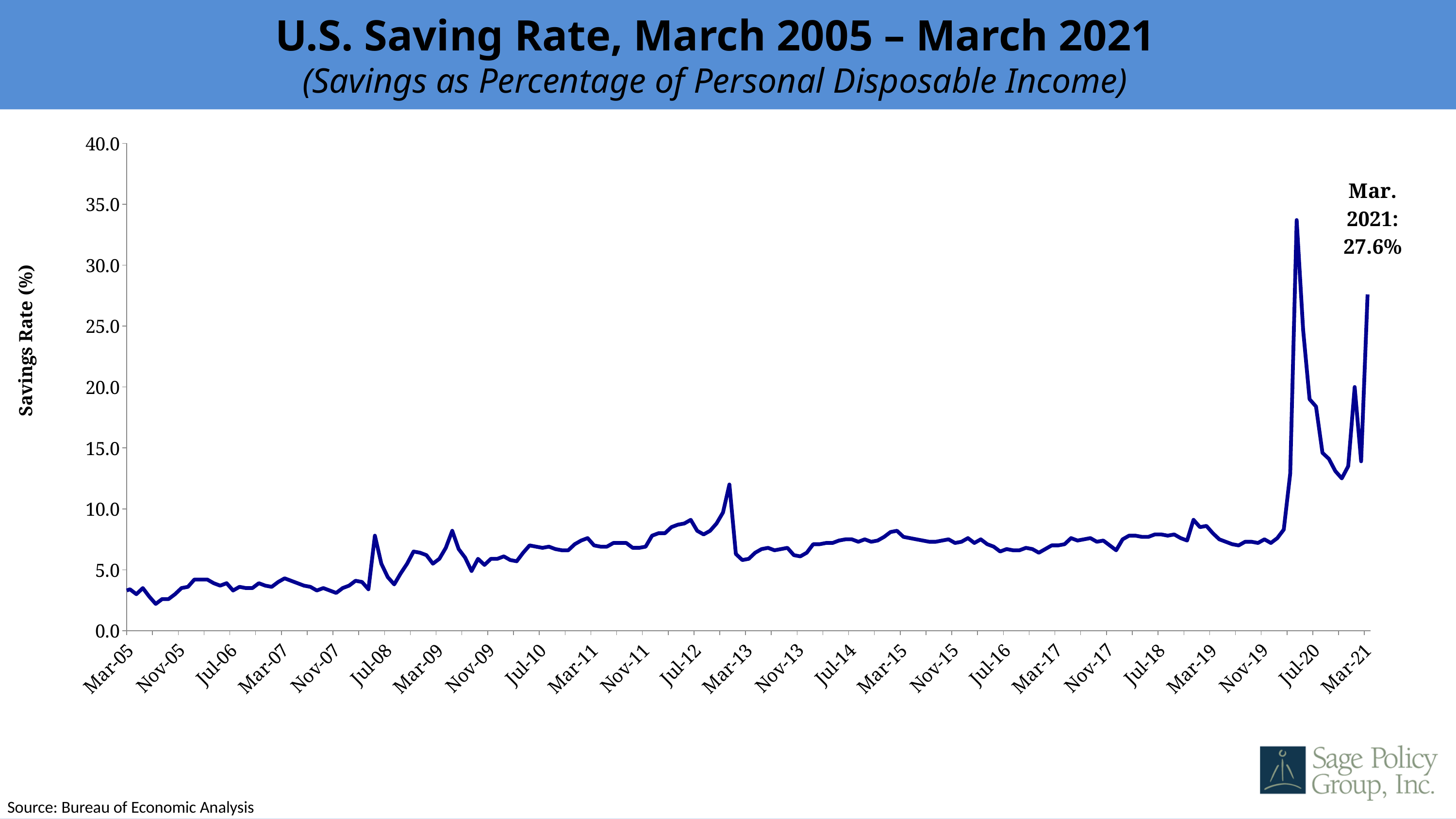
Is the saving rate at Mar-17 greater or less than 10.0? less Is the highest point on the line greater or less than 30.0? greater Is the saving rate at Mar-05 greater or less than 5.0? less Which is larger, the saving rate at Mar-05 or at Mar-21? Mar-21 What kind of chart is used to show the U.S. saving rate? line chart What is the label of the y axis? Savings Rate (%) Does the saving rate rise or fall between Nov-19 and its peak in 2020? rise What is the U.S. saving rate shown for March 2021? 27.6% What is the highest value shown on the y axis? 40.0 How many lines are plotted on the chart? 1